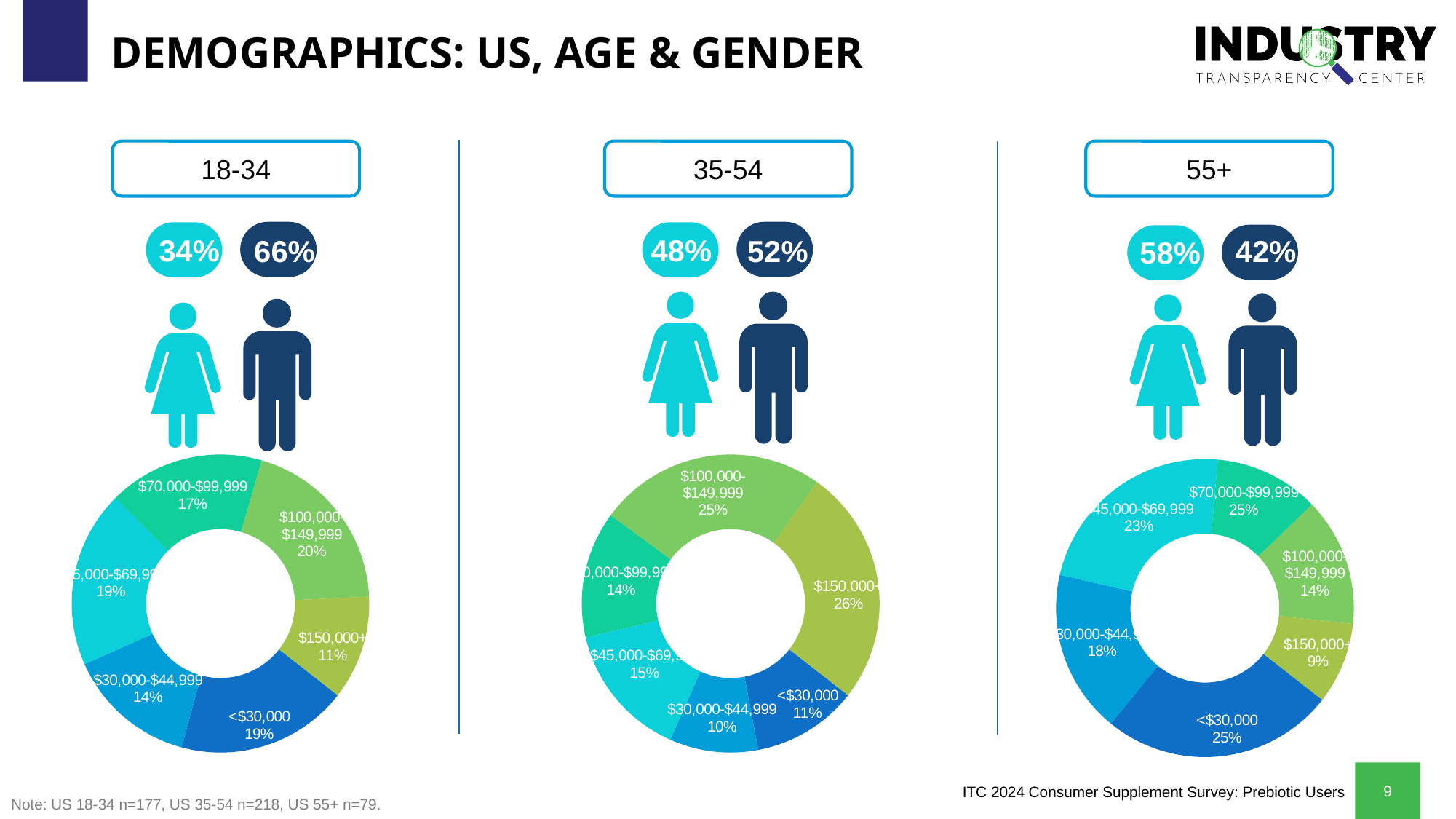
In the 18-34 donut chart, what is the difference between the $100,000-$149,999 share and the $150,000+ share? 9 percentage points In the 55+ donut chart, which income group has the smallest share? $150,000+ In the 55+ donut chart, what is the difference between the <$30,000 share and the $150,000+ share? 16 percentage points In the 55+ donut chart, what percentage is shown for the $30,000-$44,999 income group? 18% In the 35-54 donut chart, what percentage is shown for the $150,000+ income group? 26% In the 35-54 donut chart, which is larger: the share for $100,000-$149,999 or the share for $45,000-$69,999? $100,000-$149,999 What type of chart is used to show income distribution for each age group? Donut chart In the 18-34 donut chart, what percentage is shown for the $100,000-$149,999 income group? 20% How many income segments does the 35-54 donut chart contain? 6 In the 18-34 donut chart, which income group has the largest share? $100,000-$149,999 In the 35-54 donut chart, which income group has the smallest share? $30,000-$44,999 What percentage of the 55+ group is female according to the slide? 58%